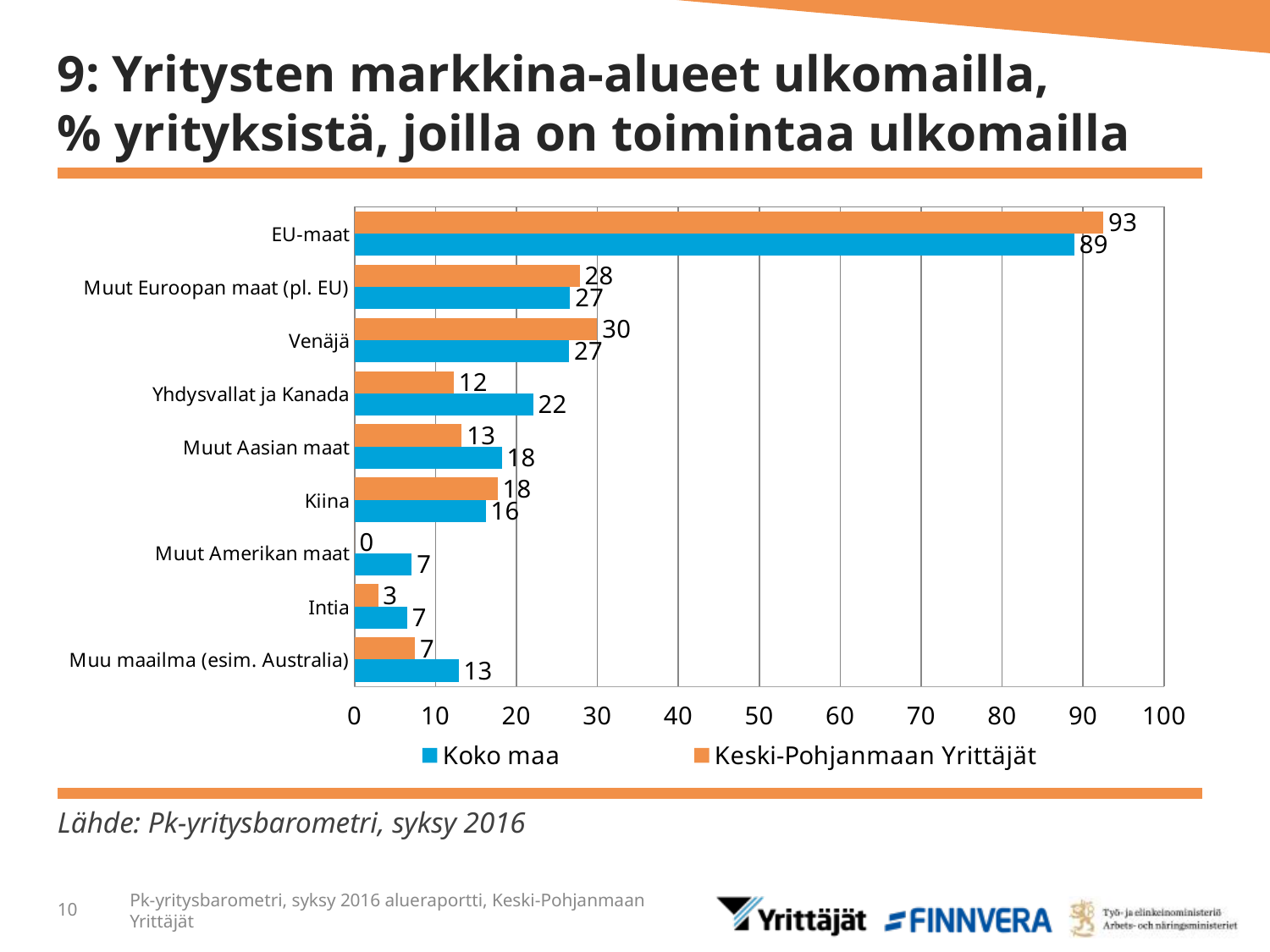
Which category has the lowest value for Keski-Pohjanmaan Yrittäjät? Muut Amerikan maat What is the difference between the Keski-Pohjanmaan Yrittäjät and Koko maa values for Yhdysvallat ja Kanada? 10 What is the value for Keski-Pohjanmaan Yrittäjät for Venäjä? 30 For Kiina, which series has the larger value, Koko maa or Keski-Pohjanmaan Yrittäjät? Keski-Pohjanmaan Yrittäjät How many categories are shown on the chart? 9 What colour are the Koko maa bars? blue How many series does the legend list? 2 Which category has the highest value for Koko maa? EU-maat What is the value for Keski-Pohjanmaan Yrittäjät for Muut Amerikan maat? 0 Is the Koko maa value for Muut Euroopan maat (pl. EU) greater or less than 20? greater What is the value for Koko maa for EU-maat? 89 What kind of chart is shown on the slide? bar chart